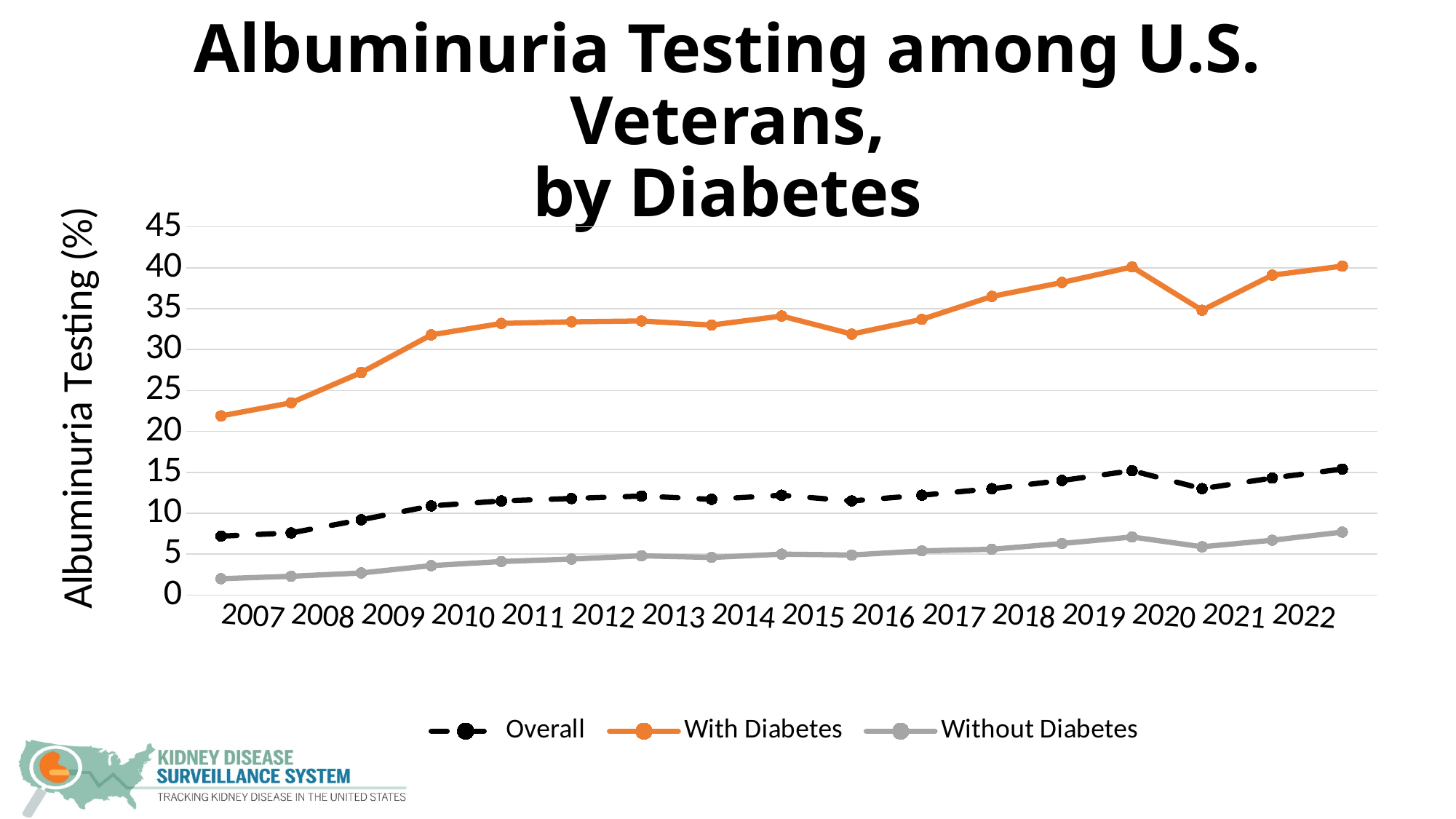
Is the value for With Diabetes in 2019 greater or less than 35? greater Is the value for With Diabetes in 2007 greater or less than 25? less Is the value for Overall in 2007 greater or less than 10? less Which series has the highest albuminuria testing percentage across all years? With Diabetes What kind of chart is shown on the slide? line chart How many series does the legend list? 3 How many years are plotted along the x axis? 16 What colour is the With Diabetes line? orange In which year is the With Diabetes series at its lowest? 2007 Does the Without Diabetes series generally rise or fall from 2007 to 2022? rise